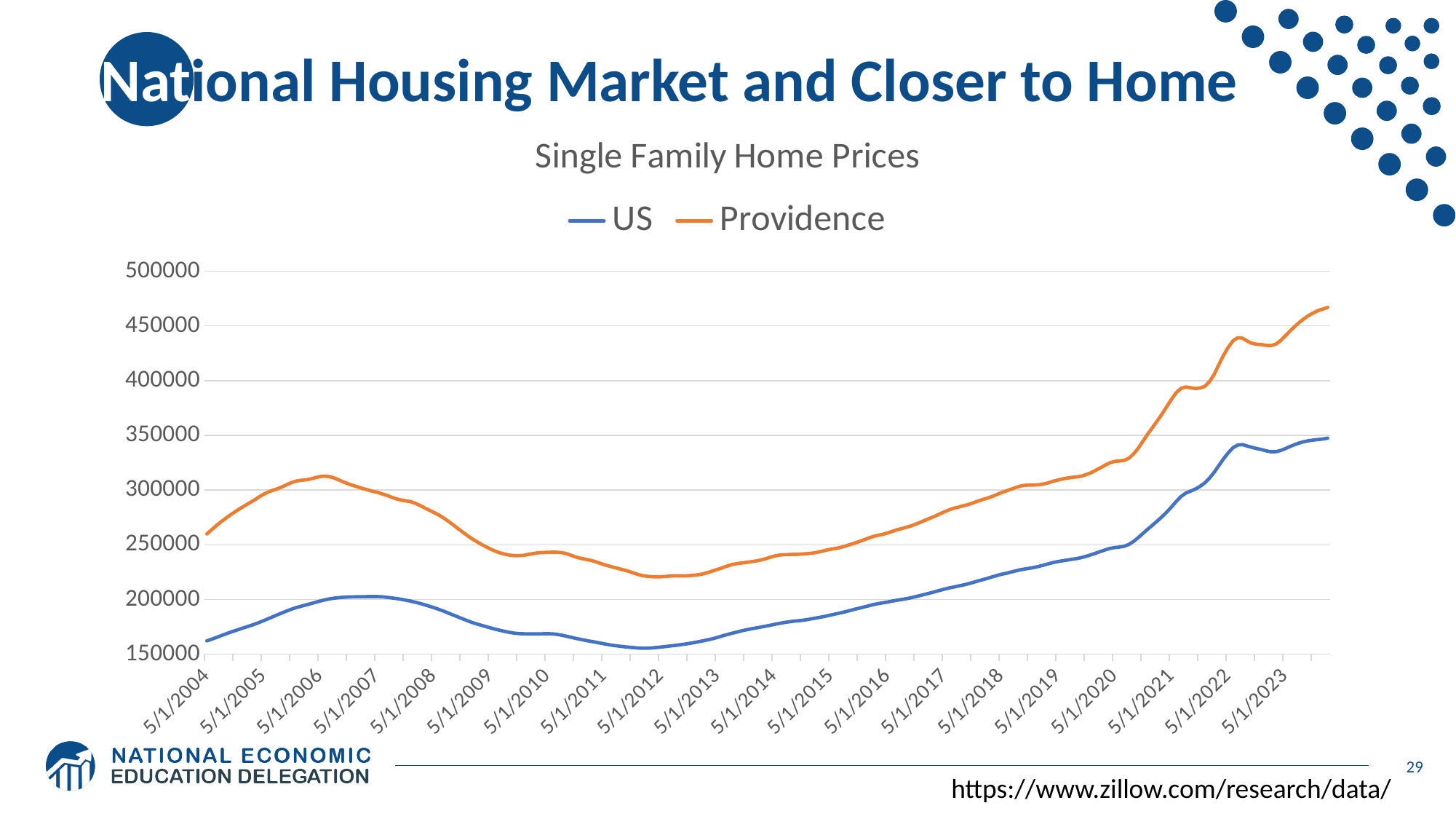
How many series does the legend list? 2 Does the US series rise or fall between 5/1/2012 and 5/1/2023? rise Is the Providence value at 5/1/2023 greater or less than 400000? greater At 5/1/2020, which series has the higher value, US or Providence? Providence What kind of chart is shown on the slide? line chart Is the US value at 5/1/2012 greater or less than 200000? less Is the Providence value at 5/1/2004 greater or less than 250000? greater How many dates are labelled on the x axis? 20 Which series reaches the highest value on the chart? Providence What is the title of the chart? Single Family Home Prices What are the two series named in the legend? US and Providence